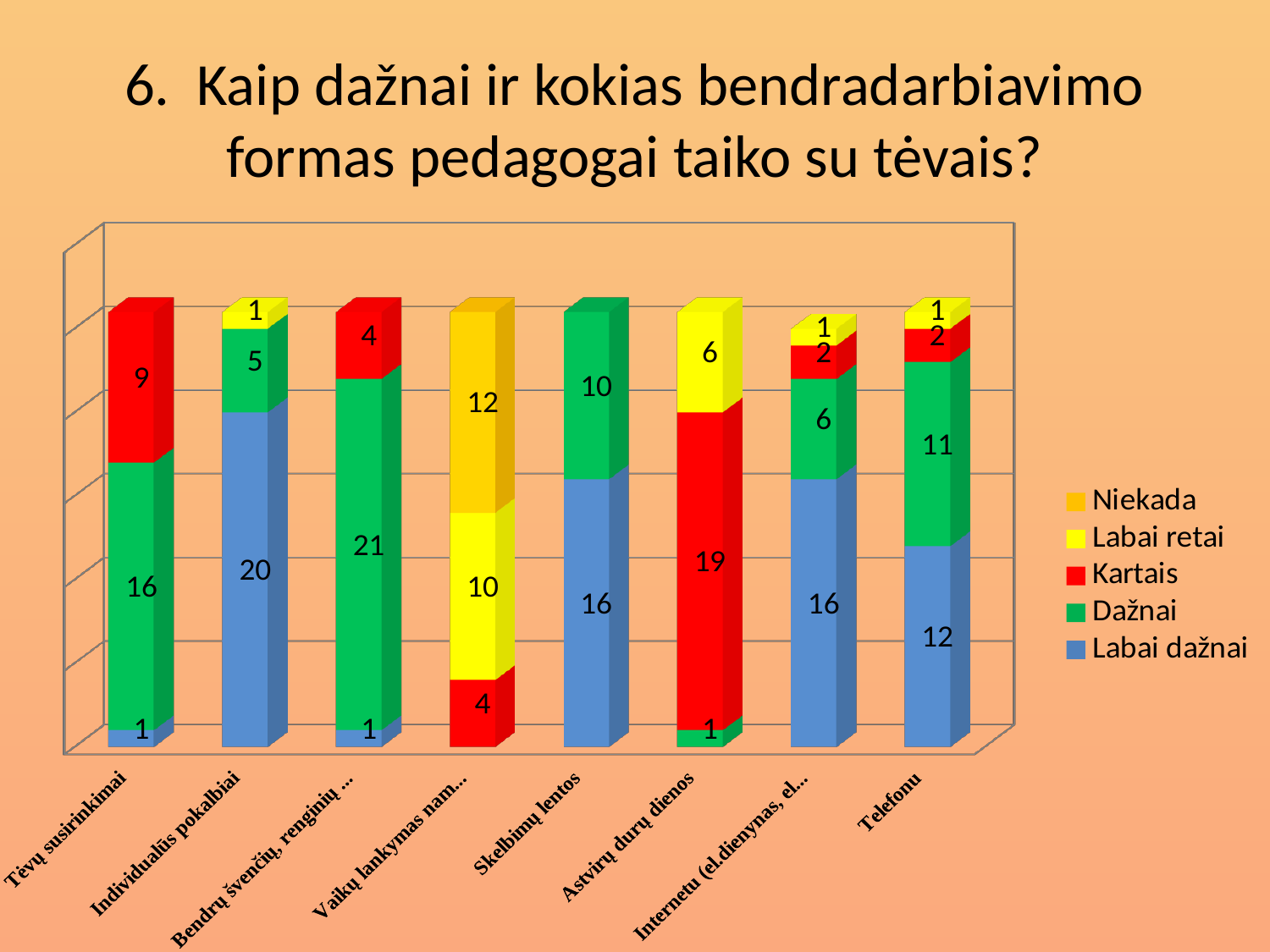
How many categories are shown on the x axis? 8 What is the total of the stacked bar for Skelbimų lentos? 26 What is the total of the stacked bar for Telefonu? 26 What is the "Labai dažnai" value for Individualūs pokalbiai? 20 What is the "Niekada" value for Vaikų lankymas nam...? 12 Which colour represents the "Kartais" series in the legend? red What is the difference between the "Dažnai" values for Bendrų švenčių, renginių ... and Tėvų susirinkimai? 5 Which is larger: the "Kartais" value for Tėvų susirinkimai or the "Kartais" value for Bendrų švenčių, renginių ...? Tėvų susirinkimai How many series does the legend list? 5 What kind of chart is shown on the slide? stacked bar chart What is the "Kartais" value for Atvirų durų dienos? 19 What is the "Dažnai" value for Telefonu? 11